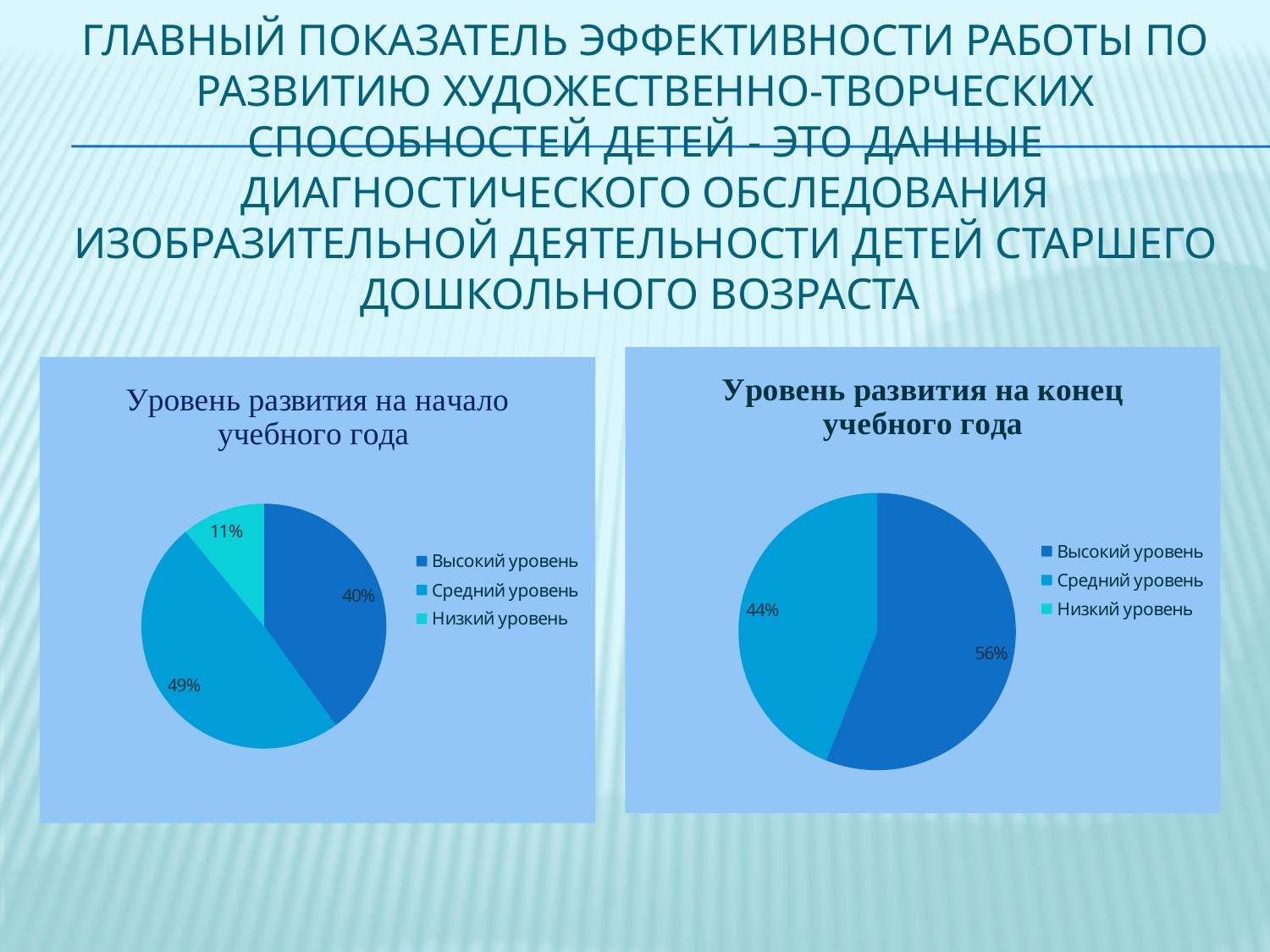
In the chart titled "Уровень развития на начало учебного года", which category has the largest slice? Средний уровень In the chart titled "Уровень развития на начало учебного года", what is the difference between "Средний уровень" and "Низкий уровень"? 38% How many entries does the legend list in the chart titled "Уровень развития на конец учебного года"? 3 In the chart titled "Уровень развития на конец учебного года", what share does "Высокий уровень" have? 56% In the chart titled "Уровень развития на начало учебного года", what share does "Высокий уровень" have? 40% What type of chart is the chart on the left of the slide? Pie chart In the chart titled "Уровень развития на начало учебного года", which category has the smallest slice? Низкий уровень In the chart titled "Уровень развития на конец учебного года", what is the difference between "Высокий уровень" and "Средний уровень"? 12% In the chart titled "Уровень развития на конец учебного года", what share does "Средний уровень" have? 44% In the chart titled "Уровень развития на начало учебного года", what share does "Средний уровень" have? 49% In the chart titled "Уровень развития на конец учебного года", which category has the largest slice? Высокий уровень In the chart titled "Уровень развития на начало учебного года", what share does "Низкий уровень" have? 11%